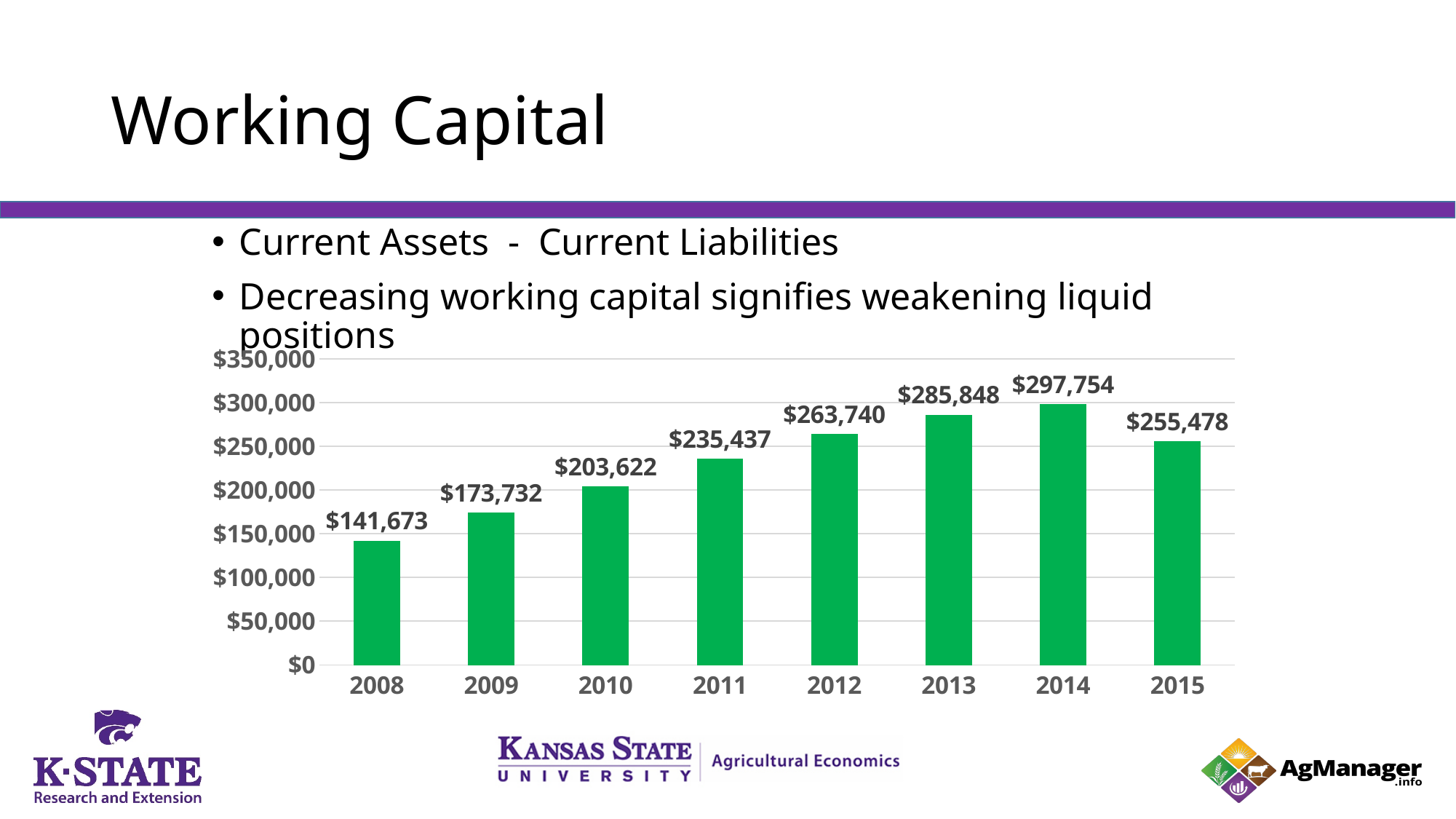
How many years are shown on the x axis of the chart? 8 Which year has a larger working capital value, 2011 or 2015? 2015 Is the working capital value for 2010 greater or less than $200,000? greater What is the difference between the working capital in 2014 and in 2013? $11,906 What is the working capital value shown for 2012? $263,740 Does working capital rise or fall from 2008 to 2014? Rise Which year has the lowest working capital in the chart? 2008 What is the working capital value shown for 2015? $255,478 By how much did working capital fall from 2014 to 2015? $42,276 What kind of chart is used to show working capital on this slide? Bar chart Which year has the highest working capital in the chart? 2014 What is the working capital value shown for 2008? $141,673